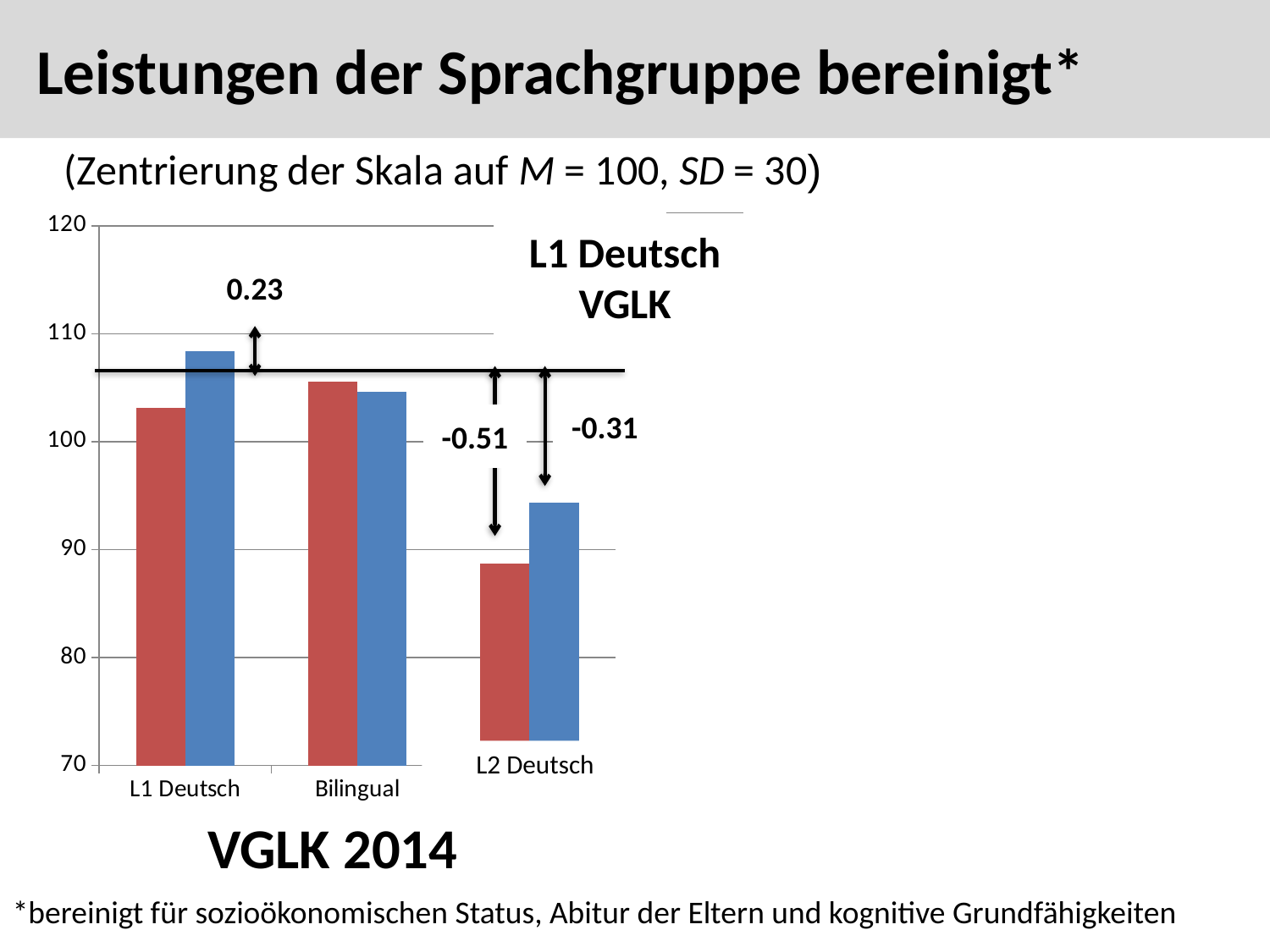
Is the value of the blue bar for L1 Deutsch greater or less than 100? greater How many categories are shown on the x axis of the chart? 3 What kind of chart is shown on the slide? bar chart Is the value of the red bar for L2 Deutsch greater or less than 90? less Which category has the lowest blue bar? L2 Deutsch For L1 Deutsch, which bar is larger, the red bar or the blue bar? the blue bar What value is annotated next to the arrow above the L1 Deutsch bars? 0.23 Which category has the highest blue bar? L1 Deutsch How many bars are shown for each category in the chart? 2 For L2 Deutsch, which bar is larger, the red bar or the blue bar? the blue bar Is the value of the blue bar for L2 Deutsch greater or less than 90? greater